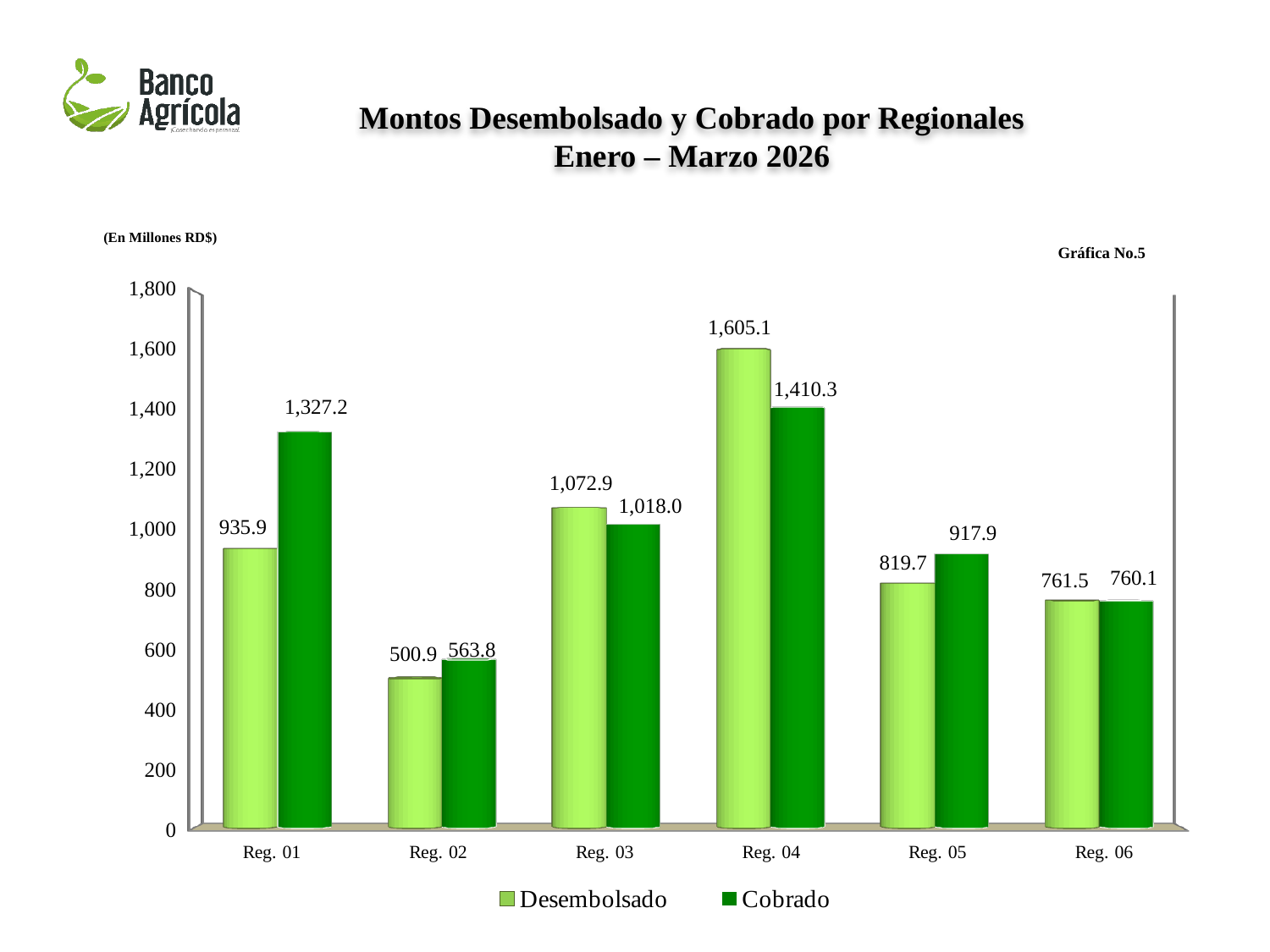
What is the Desembolsado value for Reg. 04? 1,605.1 Which region has the lowest Cobrado value? Reg. 02 How many series does the legend list? 2 What is the difference between the Cobrado and Desembolsado values for Reg. 01? 391.3 What is the Cobrado value for Reg. 01? 1,327.2 How many regions are shown on the x axis? 6 For Reg. 05, which is larger, Desembolsado or Cobrado? Cobrado What is the Cobrado value for Reg. 03? 1,018.0 Is the Desembolsado value for Reg. 02 greater or less than 600? less What is the Desembolsado value for Reg. 05? 819.7 Which region has the highest Desembolsado value? Reg. 04 What is the difference between the Desembolsado and Cobrado values for Reg. 04? 194.8